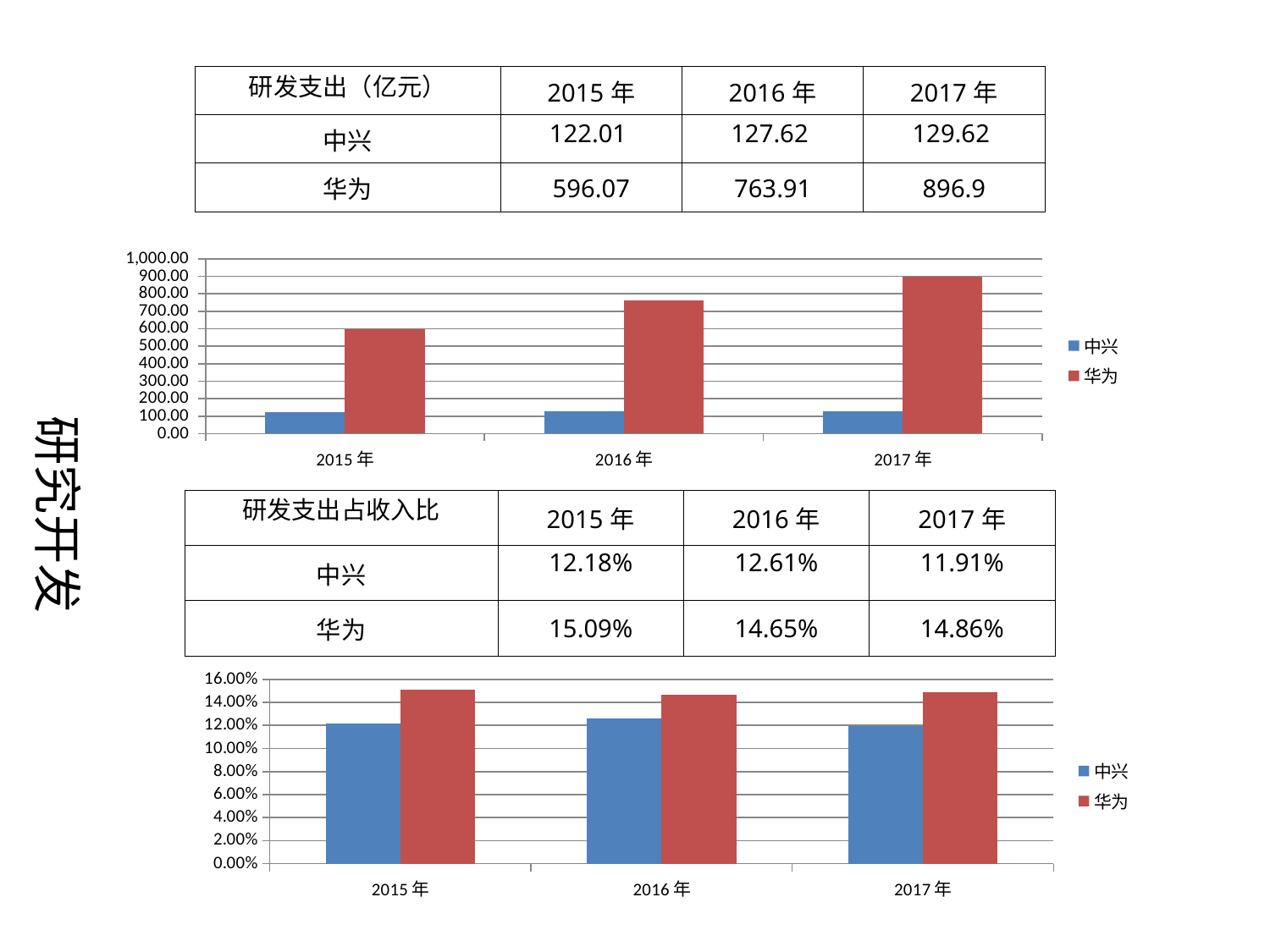
What kind of chart is the bottom chart? bar chart In the top chart, what is the value for 中兴 in 2015年? 122.01 In the top chart, what is the value for 华为 in 2017年? 896.9 In the top chart, is the value for 华为 in 2015年 greater or less than 500.00? greater In the bottom chart, which year has the lowest value for 中兴? 2017年 How many series does the legend of the top chart list? 2 In the top chart, what is the difference between 华为 and 中兴 in 2016年? 636.29 How many years are shown on the x axis of the bottom chart? 3 In the bottom chart, which is larger in 2016年, 中兴 or 华为? 华为 In the top chart, which year has the highest value for 华为? 2017年 In the top chart, do the values for 华为 rise or fall from 2015年 to 2017年? rise In the bottom chart, what is the value for 华为 in 2015年? 15.09%